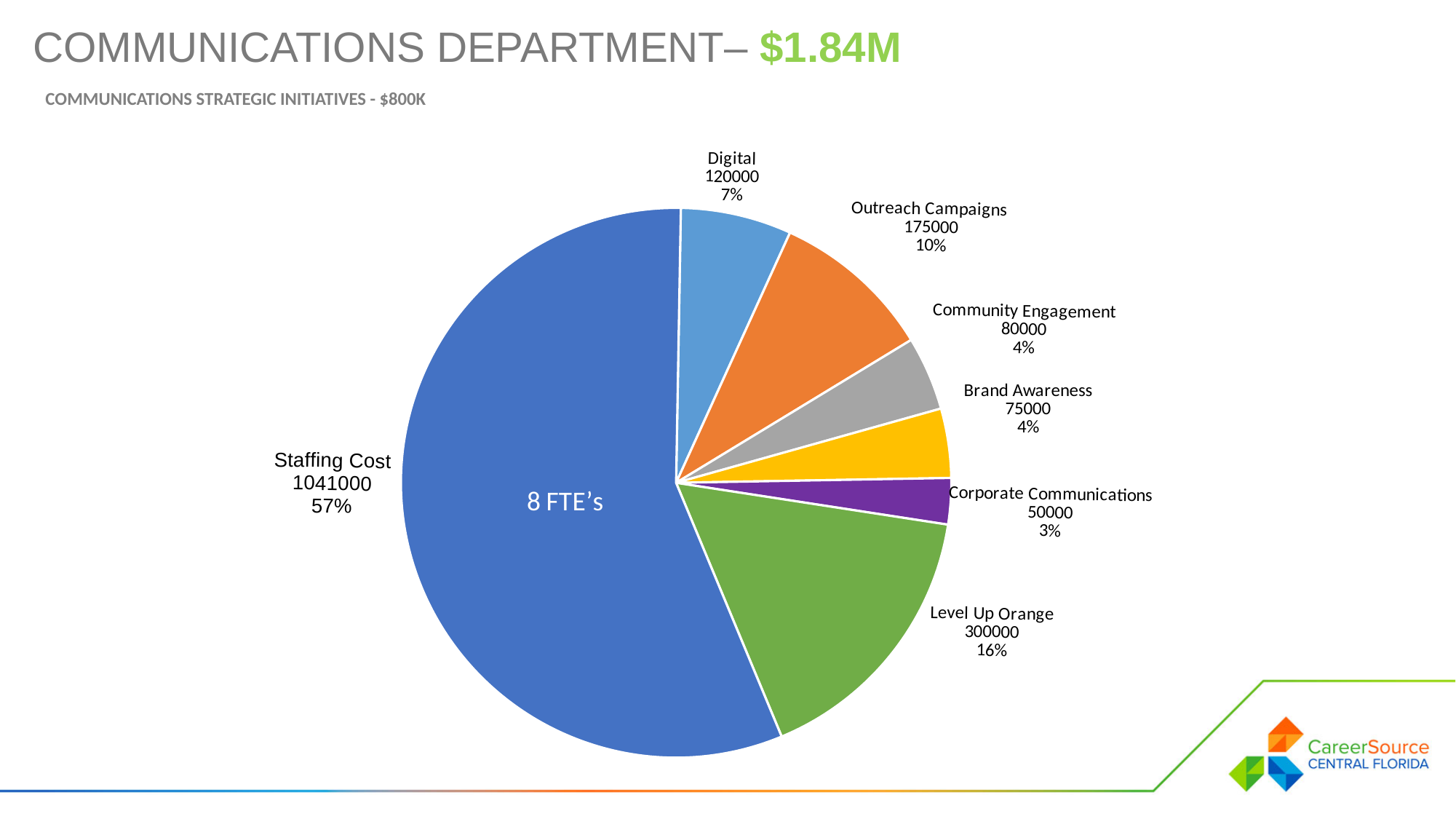
Which is larger, the value for Digital or the value for Community Engagement? Digital What kind of chart is shown on the slide? Pie chart Which category has the largest slice? Staffing Cost What share of the pie does Digital represent? 7% How many slices does the pie chart have? 7 Which category has the smallest slice? Corporate Communications What is the value for Staffing Cost? 1041000 What text is written inside the Staffing Cost slice? 8 FTE's What is the difference between the values for Level Up Orange and Outreach Campaigns? 125000 What share of the pie does Corporate Communications represent? 3% What is the value for Level Up Orange? 300000 What is the value for Outreach Campaigns? 175000